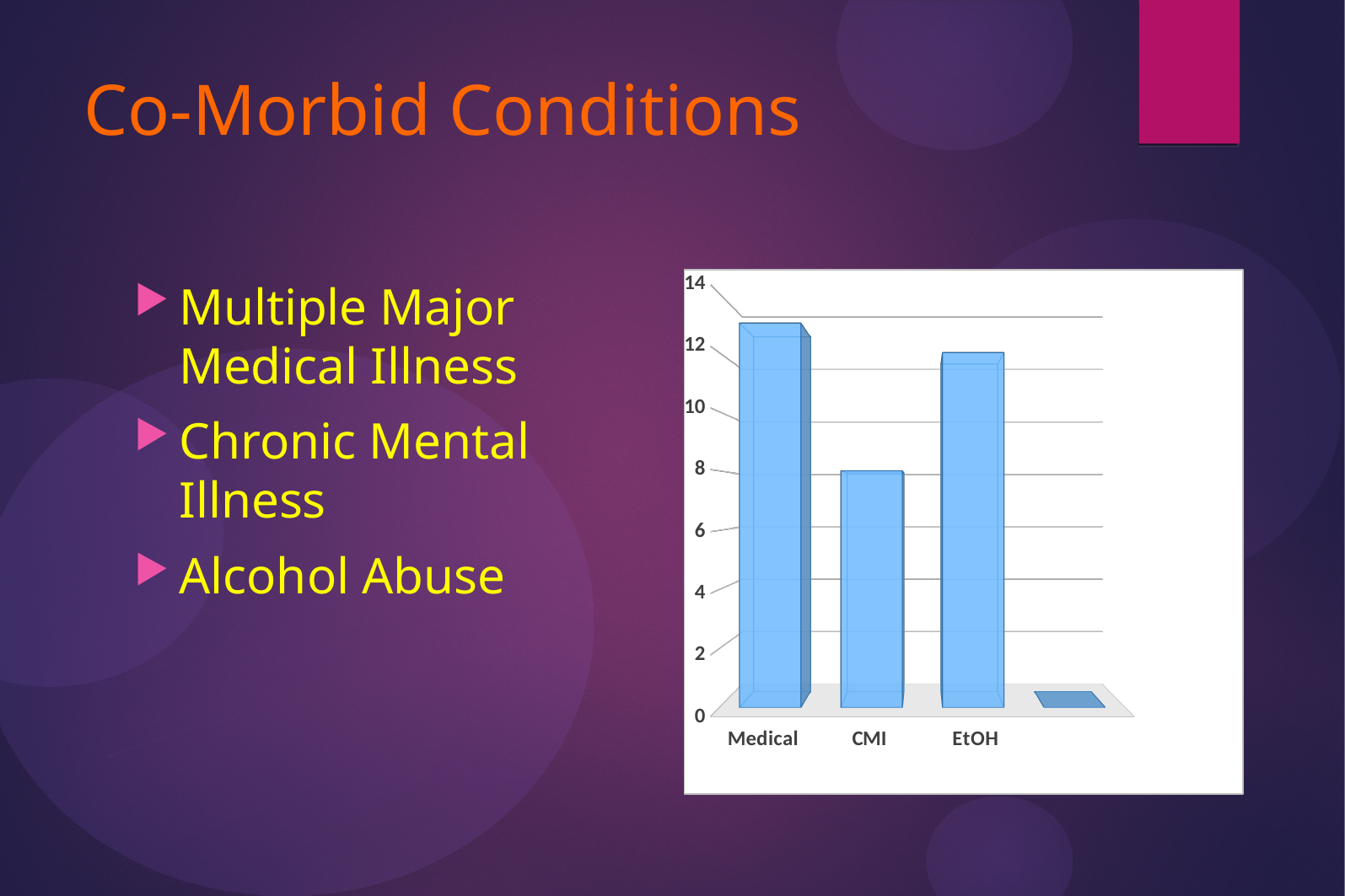
Is the value for EtOH greater or less than 10? greater What kind of chart is shown on the slide? bar chart How many category labels appear on the x axis of the chart? 3 Which is larger, the value for EtOH or the value for CMI? EtOH Which category has the tallest bar? Medical Which is larger, the value for Medical or the value for EtOH? Medical Is the value for CMI greater or less than 6? greater Is the value for CMI greater or less than 10? less Which labeled category has the shortest bar? CMI What is the highest value shown on the chart's vertical axis? 14 Is the bar for Medical taller or shorter than the bar for CMI? taller